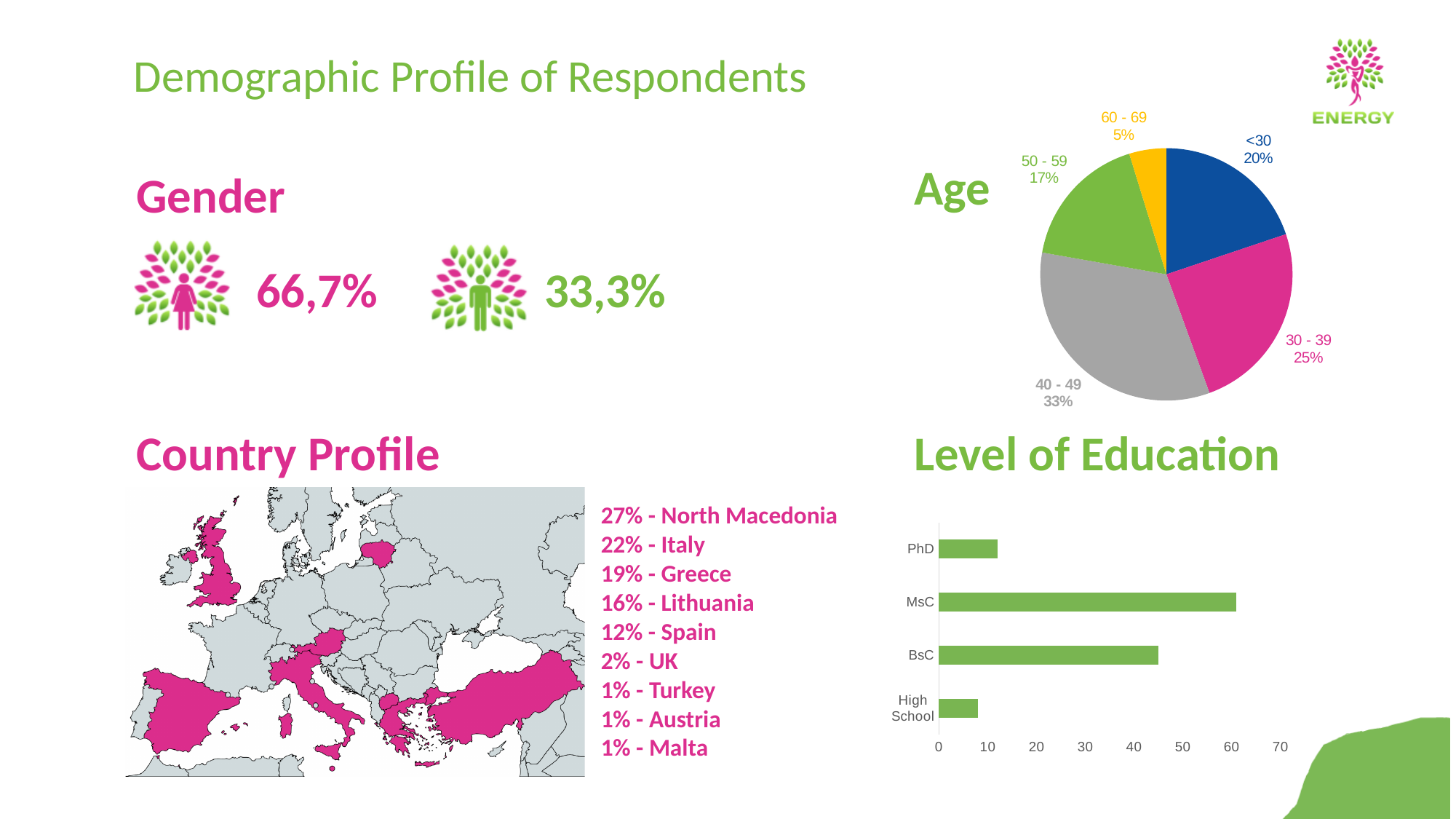
In the Age pie chart, which age group has the smallest share? 60 - 69 What type of chart is used for the Age breakdown? pie chart What type of chart is used for Level of Education? bar chart In the Age pie chart, which group has a larger share: <30 or 30 - 39? 30 - 39 In the Age pie chart, which age group has the largest share? 40 - 49 In the Level of Education chart, which level has the lowest value? High School In the Age pie chart, what share of respondents are under 30? 20% In the Level of Education chart, which level has the highest value? MsC In the Age pie chart, what is the difference in percentage points between the 30 - 39 and 50 - 59 groups? 8 How many age groups are shown in the Age pie chart? 5 In the Age pie chart, what share of respondents are aged 40 - 49? 33% In the Level of Education chart, is the value for BsC greater or less than 50? less